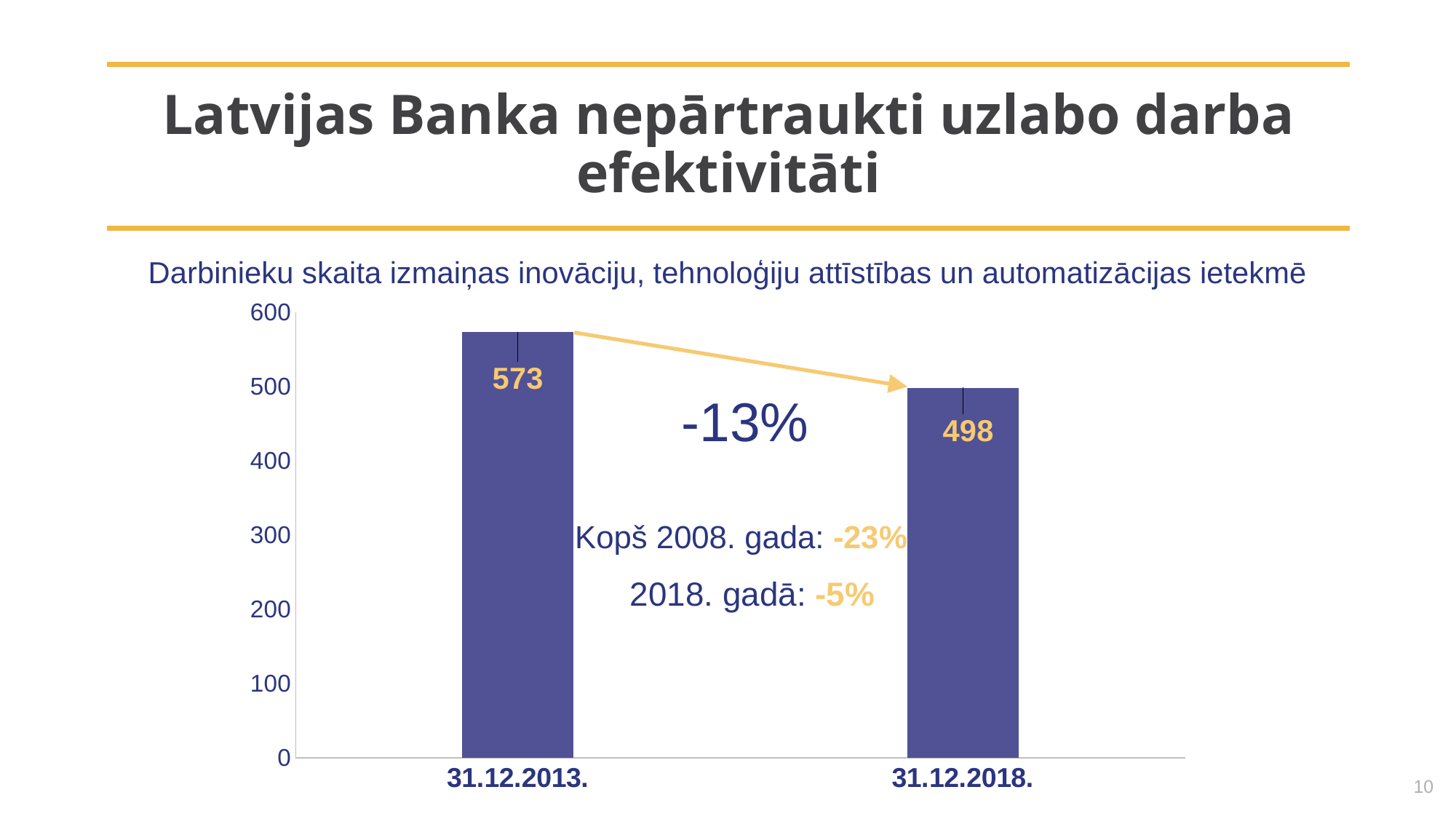
How many categories are shown on the x axis? 2 What is the value for 31.12.2018.? 498 What is the difference between the values for 31.12.2013. and 31.12.2018.? 75 What kind of chart is shown on the slide? bar chart Which category has the lowest value? 31.12.2018. What is the highest value shown on the y axis? 600 Which category has the highest value? 31.12.2013. Is the value for 31.12.2018. greater or less than 500? less What is the value for 31.12.2013.? 573 Do the values rise or fall from 31.12.2013. to 31.12.2018.? fall What percentage change is shown between the two bars? -13% Which is larger, the value for 31.12.2013. or for 31.12.2018.? 31.12.2013.